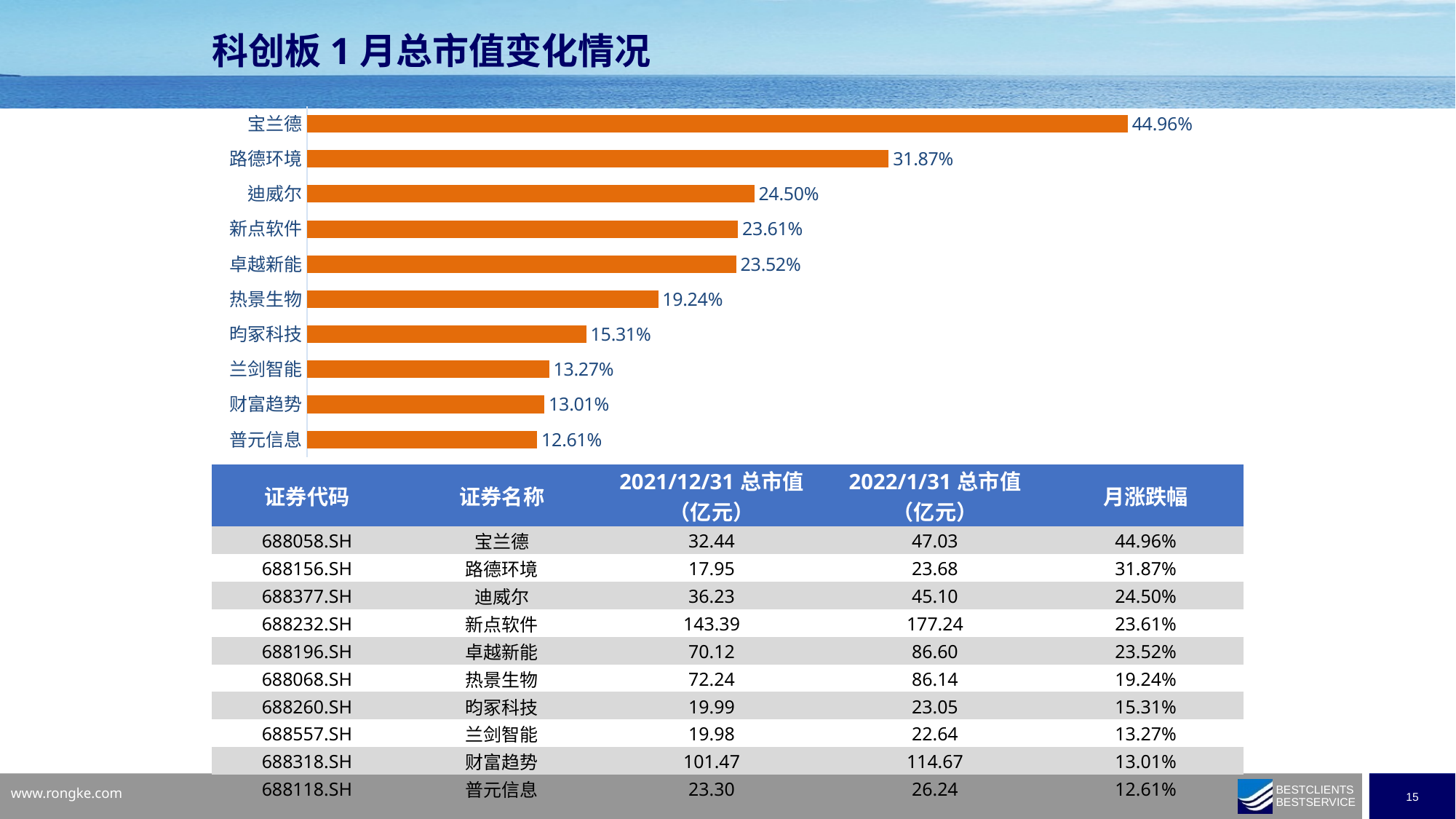
What is the difference between the values for 迪威尔 and 新点软件? 0.89% Which category has the lowest value in the bar chart? 普元信息 What is the title of the slide containing the chart? 科创板 1 月总市值变化情况 What is the value shown for 宝兰德 in the bar chart? 44.96% Do the bar values increase or decrease from the top category to the bottom category? decrease Which category has the highest value in the bar chart? 宝兰德 What is the value shown for 普元信息 in the bar chart? 12.61% What is the value shown for 热景生物 in the bar chart? 19.24% What is the difference between the values for 宝兰德 and 路德环境? 13.09% What kind of chart is shown on the slide? bar chart How many categories are shown in the bar chart? 10 Which is larger, the value for 昀冢科技 or the value for 兰剑智能? 昀冢科技